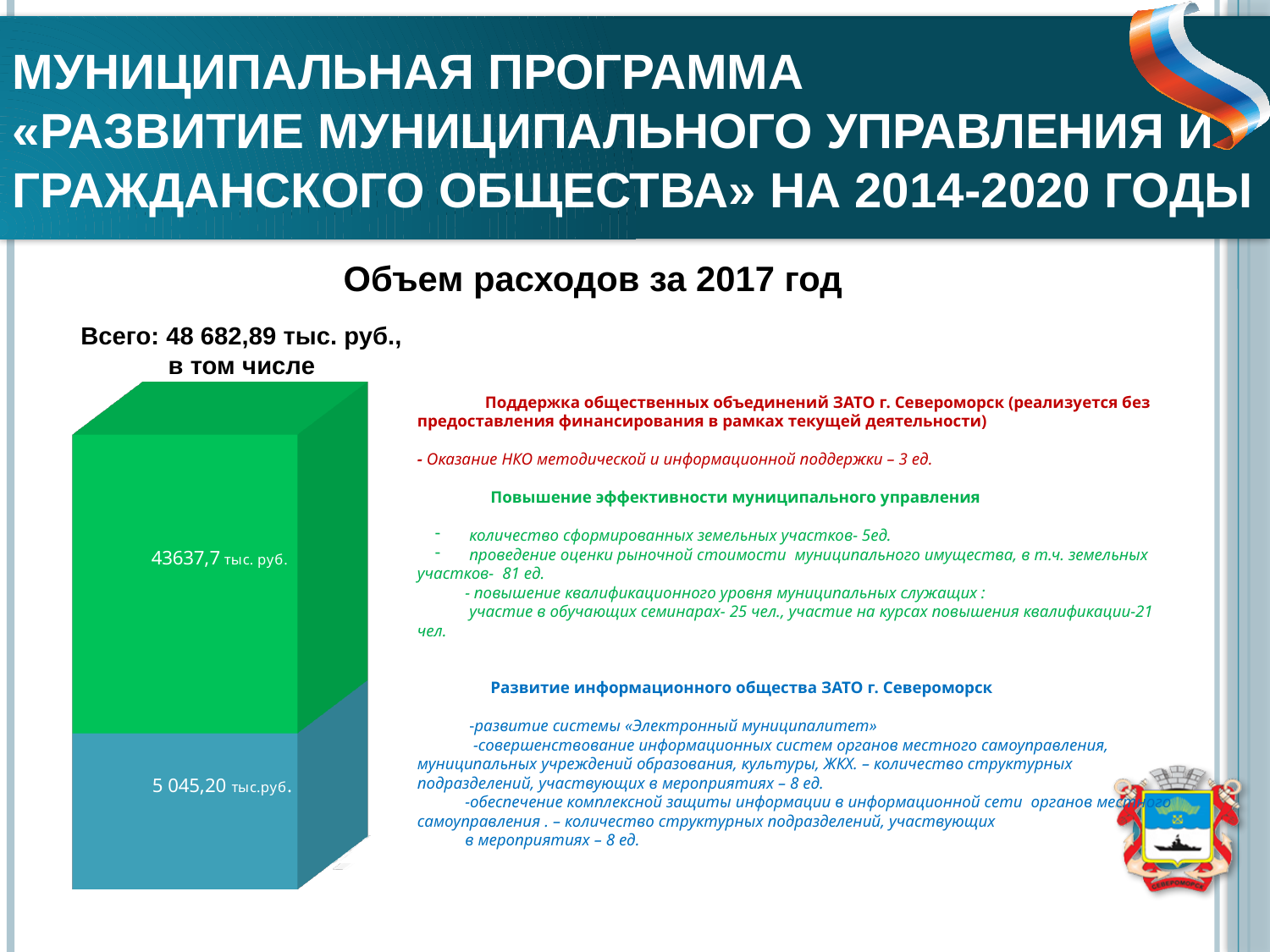
Which segment is at the bottom of the stacked bar, the green one or the blue one? the blue one How many segments does the stacked bar have? 2 Which segment of the bar has the largest value? the green segment (43637,7 тыс. руб.) Which segment of the bar is larger, the green one or the blue one? the green one What value is printed on the green segment of the bar? 43637,7 тыс. руб. What is the total of the stacked bar as stated on the slide? 48 682,89 тыс. руб. What kind of chart is shown on the slide? bar chart Which segment of the bar has the smallest value? the blue segment (5 045,20 тыс.руб.) What is the title above the chart? Объем расходов за 2017 год What value is printed on the blue segment of the bar? 5 045,20 тыс.руб.